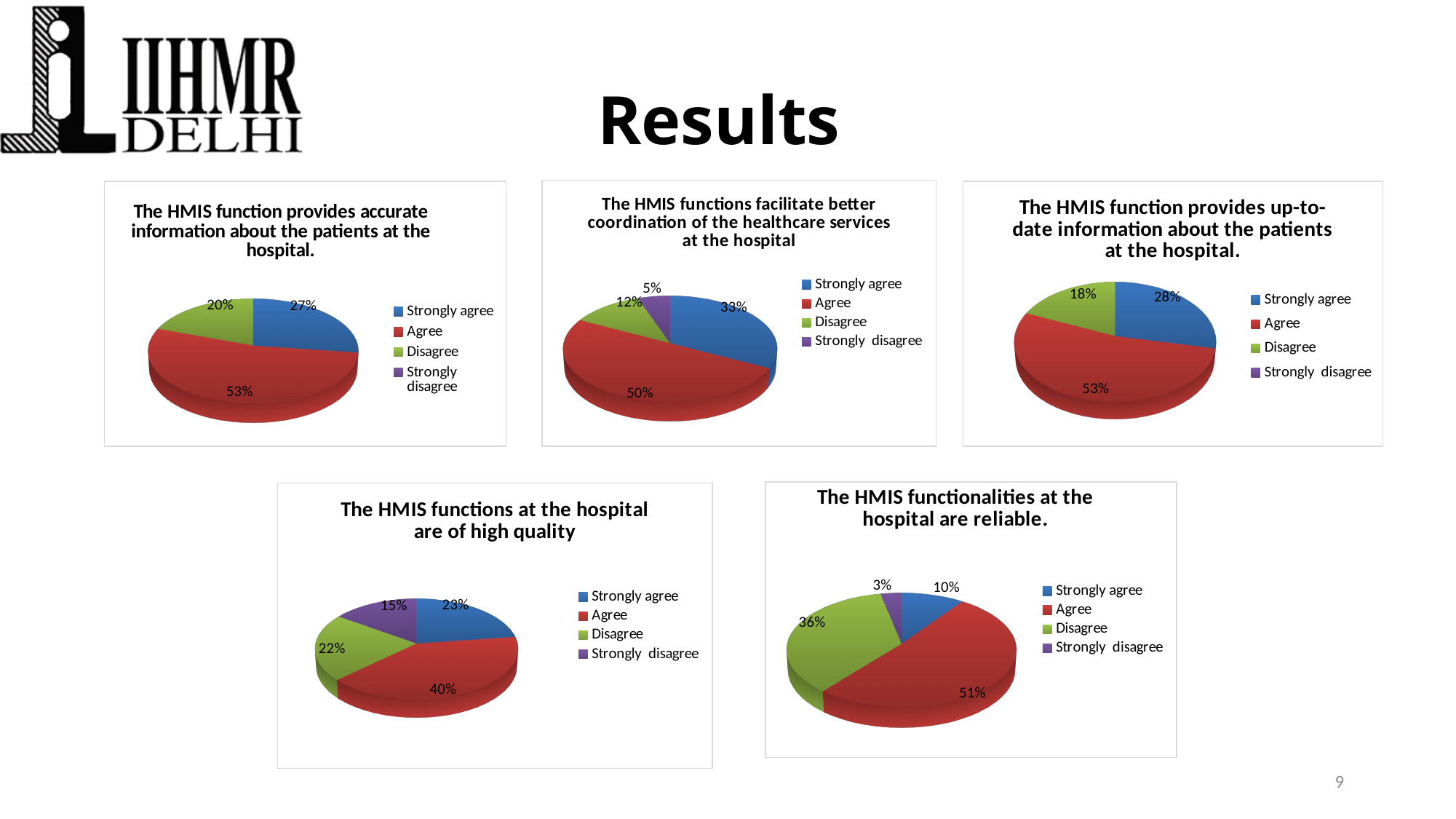
How many entries does the legend list in the chart titled 'The HMIS functions at the hospital are of high quality'? 4 In the chart titled 'The HMIS functions at the hospital are of high quality', which is larger, the Strongly agree share or the Disagree share? Strongly agree In the chart titled 'The HMIS functions facilitate better coordination of the healthcare services at the hospital', what share of respondents chose Strongly disagree? 5% In the chart titled 'The HMIS functions at the hospital are of high quality', what share of respondents chose Strongly disagree? 15% What type of chart is used for 'The HMIS functionalities at the hospital are reliable'? Pie chart In the chart titled 'The HMIS functionalities at the hospital are reliable', what share of respondents chose Disagree? 36% In the chart titled 'The HMIS function provides up-to-date information about the patients at the hospital', what is the difference between the Agree and Disagree shares? 35% In the chart titled 'The HMIS function provides accurate information about the patients at the hospital', what share of respondents chose Disagree? 20% In the chart titled 'The HMIS function provides up-to-date information about the patients at the hospital', what share of respondents chose Strongly agree? 28% In the chart titled 'The HMIS functions facilitate better coordination of the healthcare services at the hospital', which response has the largest share? Agree In the chart titled 'The HMIS functionalities at the hospital are reliable', which response has the smallest share? Strongly disagree In the chart titled 'The HMIS function provides accurate information about the patients at the hospital', what share of respondents chose Agree? 53%